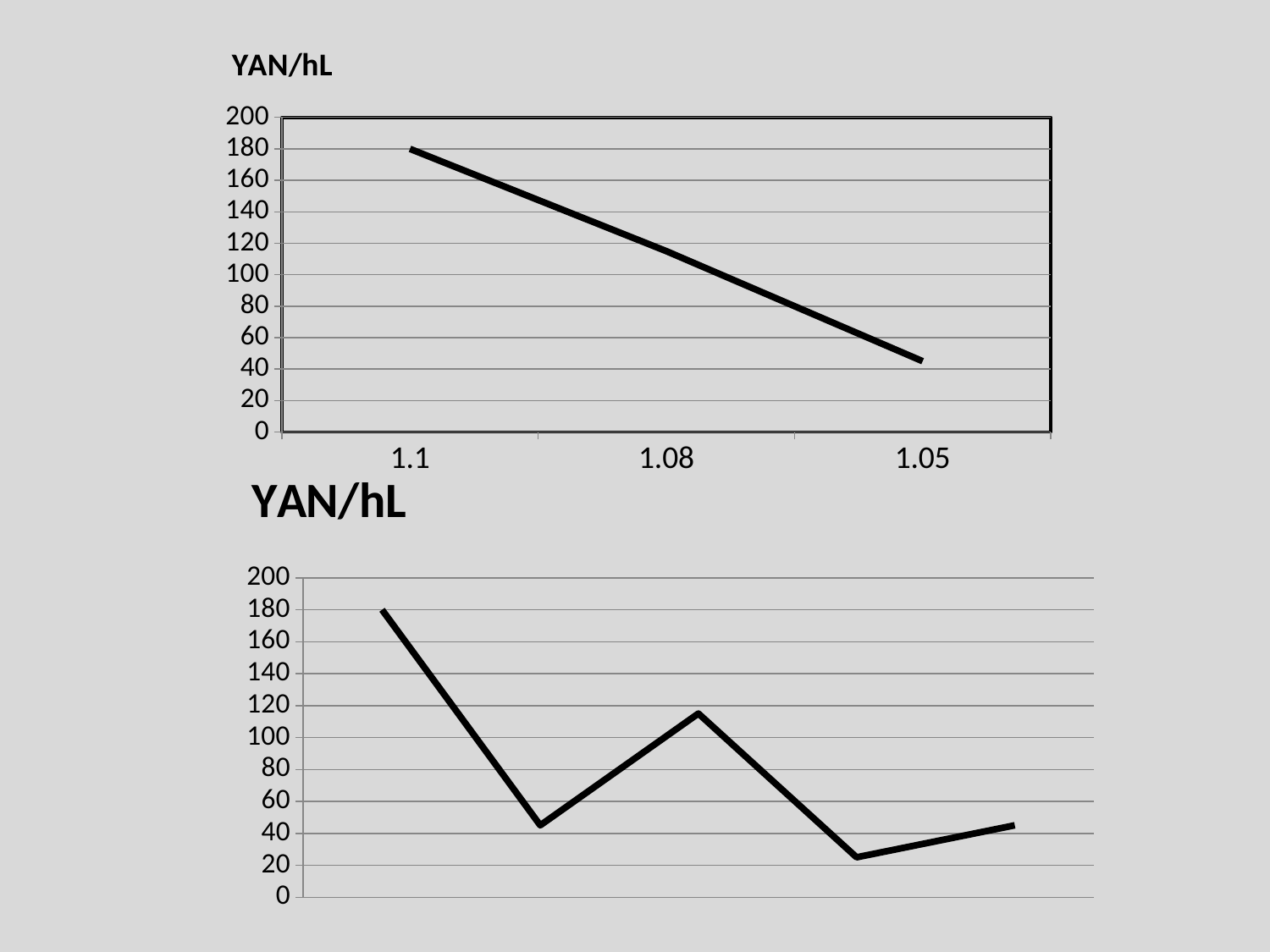
In the top chart, do the values rise or fall from 1.1 to 1.05 along the x axis? fall In the bottom chart, how many data points does the line have? 5 In the top chart, which x-axis category has the higher value, 1.1 or 1.05? 1.1 In the top chart, is the value at 1.05 greater or less than 60? less In the bottom chart, is the first data point greater or less than 160? greater In the bottom chart, is the fourth data point greater or less than 40? less What kind of chart is the top chart on the slide? line chart What kind of chart is the bottom chart on the slide? line chart What is the title shown above the bottom chart? YAN/hL In the top chart, how many x-axis categories are labelled? 3